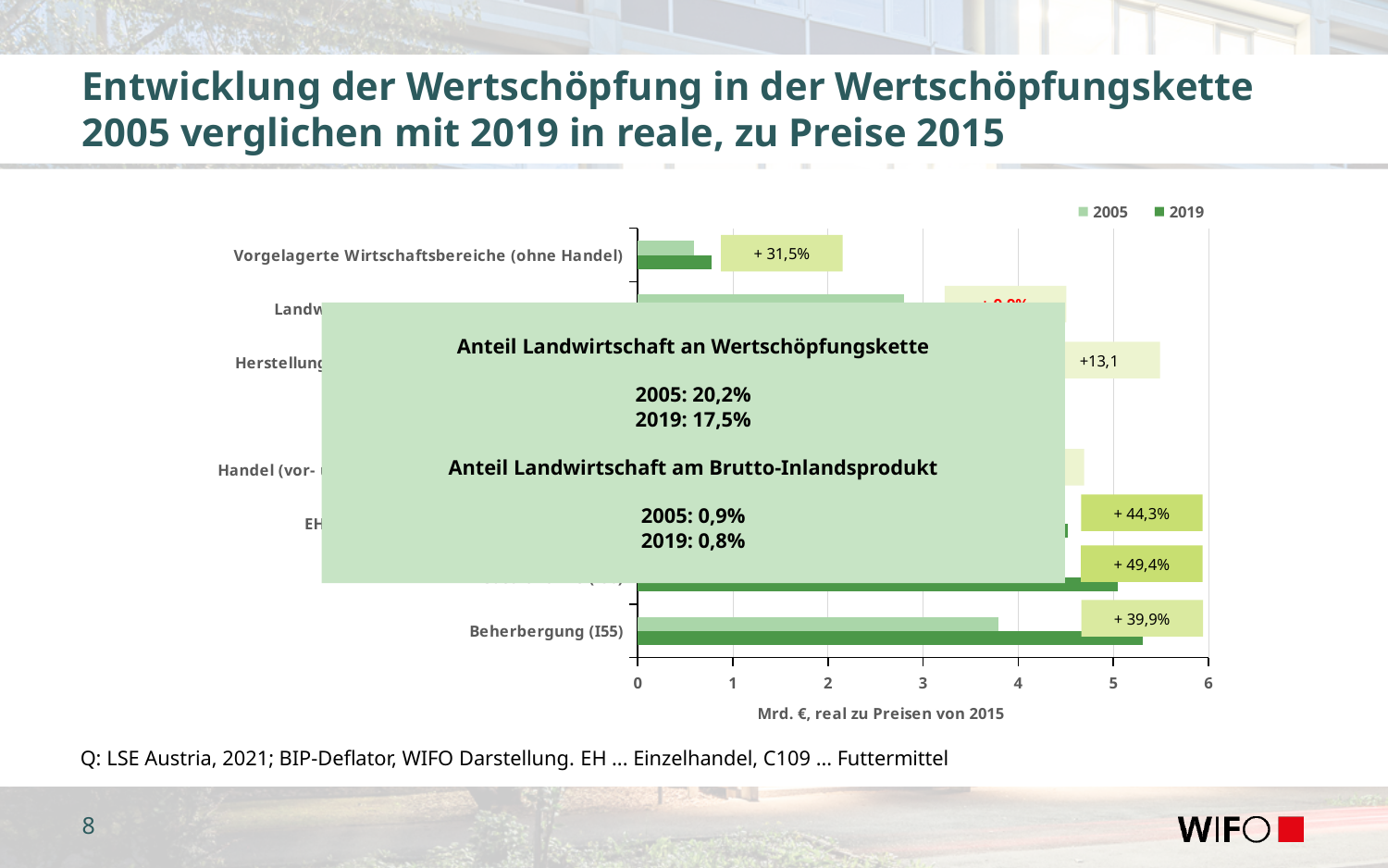
How many series does the chart legend list? 2 What kind of chart is shown on the slide? bar chart For 'Beherbergung (I55)', which year has the larger value, 2005 or 2019? 2019 Which two years are listed in the chart legend? 2005 and 2019 What percentage change is labelled for 'Vorgelagerte Wirtschaftsbereiche (ohne Handel)'? + 31,5% Is the 2005 value for 'Beherbergung (I55)' greater or less than 4? less For 'Vorgelagerte Wirtschaftsbereiche (ohne Handel)', which year has the larger value, 2005 or 2019? 2019 What percentage change is labelled for 'Beherbergung (I55)'? + 39,9% What is the highest value shown on the chart's x axis? 6 Is the 2005 value for 'Vorgelagerte Wirtschaftsbereiche (ohne Handel)' greater or less than 1? less Is the 2019 value for 'Beherbergung (I55)' greater or less than 5? greater